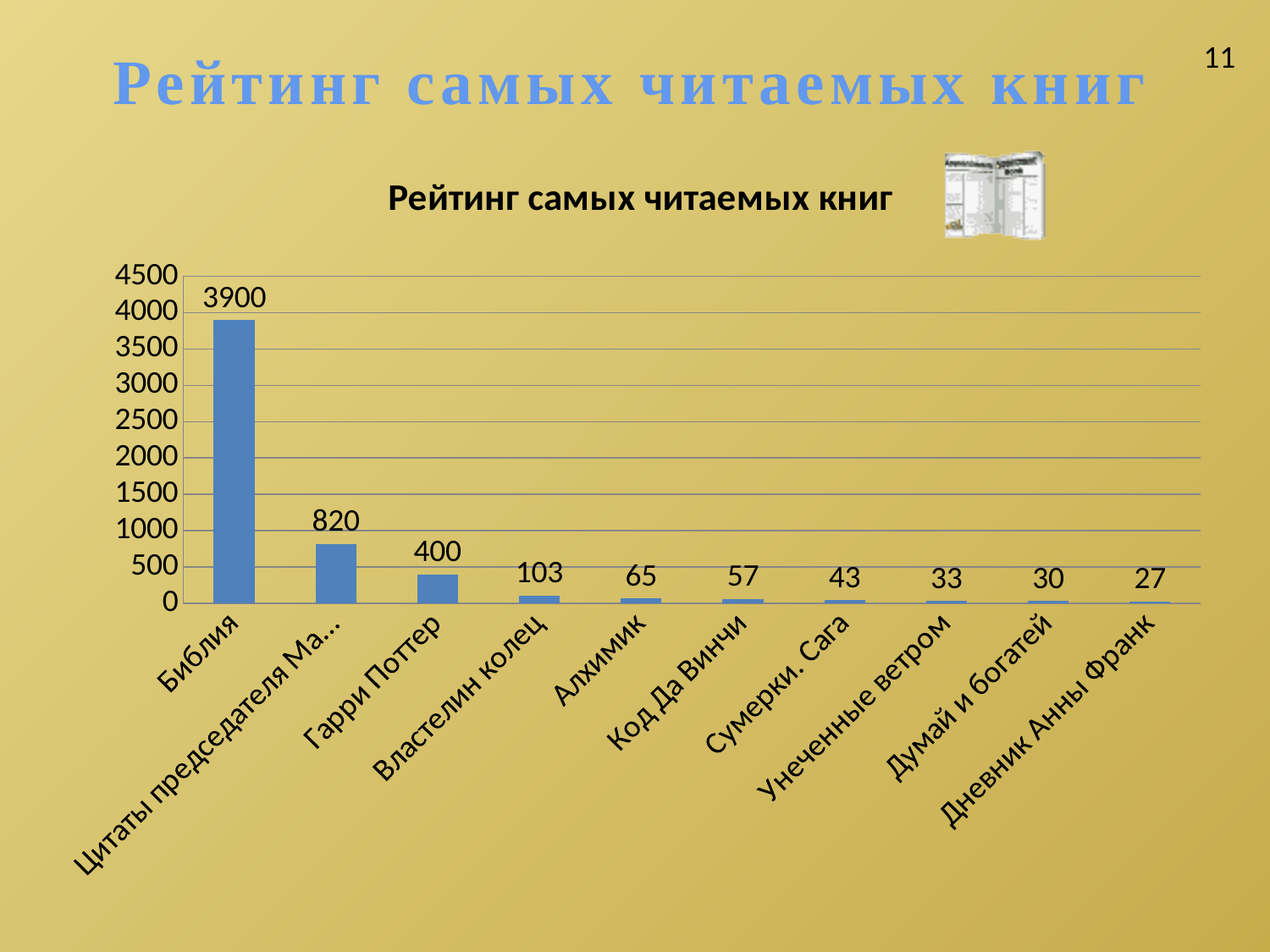
What is the value for Гарри Поттер? 400 What is the value for Дневник Анны Франк? 27 What is the difference between the values for Библия and Гарри Поттер? 3500 What is the value for Библия? 3900 Which is larger, the value for Алхимик or the value for Код Да Винчи? Алхимик Which book has the highest value? Библия What is the title of the chart? Рейтинг самых читаемых книг What is the value for Властелин колец? 103 Which book has the lowest value? Дневник Анны Франк How many books are shown in the chart? 10 What kind of chart is shown on the slide? Bar chart Do the values rise or fall from left to right along the x axis? Fall